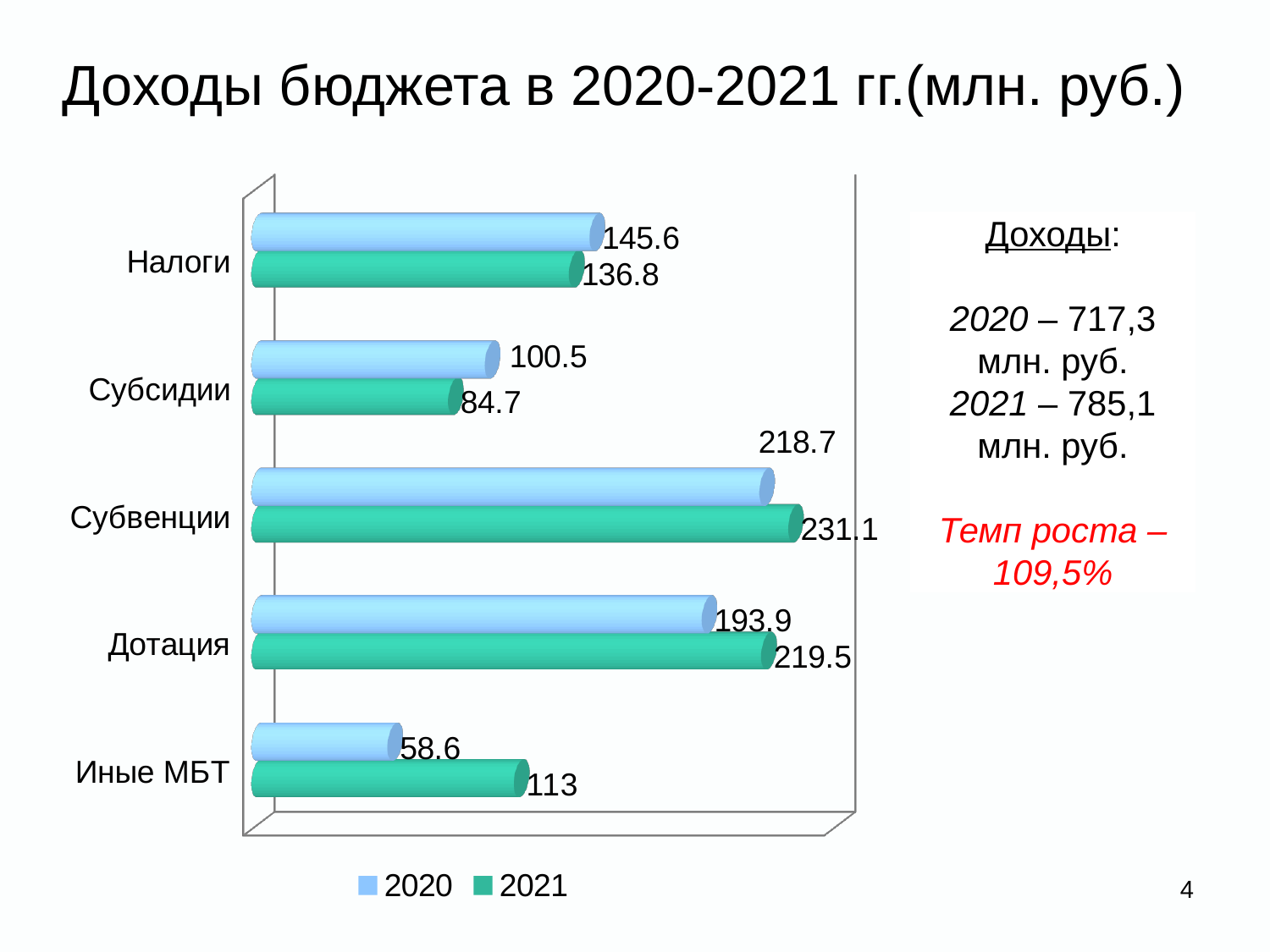
What is the value for Иные МБТ in the 2021 series? 113 What is the difference between the 2021 and 2020 values for Дотация? 25.6 How many series does the legend list? 2 What is the value for Субсидии in the 2021 series? 84.7 Which category has the highest value in the 2021 series? Субвенции Which is larger for Субсидии: the 2020 value or the 2021 value? 2020 What is the value for Субвенции in the 2021 series? 231.1 What kind of chart is shown on the slide? Bar chart Which category has the lowest value in the 2020 series? Иные МБТ What is the value for Налоги in the 2020 series? 145.6 What is the difference between the 2020 and 2021 values for Иные МБТ? 54.4 How many categories are shown on the chart? 5